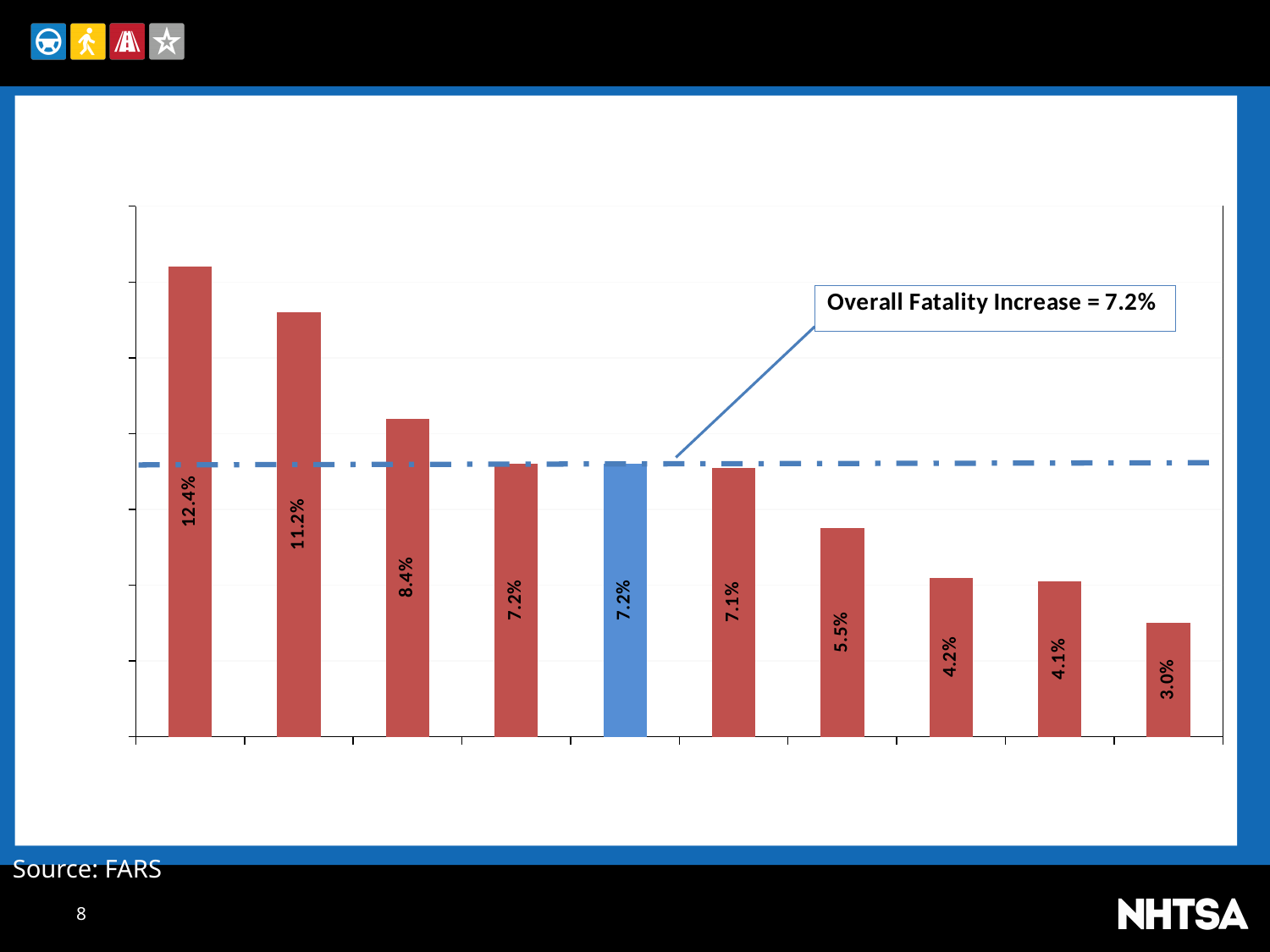
What is the value shown on the tallest bar in the chart? 12.4% What kind of chart is shown on the slide? bar chart What value is labelled on the blue bar in the chart? 7.2% What is the difference between the leftmost bar (12.4%) and the rightmost bar (3.0%)? 9.4% What value is labelled on the rightmost bar? 3.0% What value is labelled on the second bar from the left? 11.2% What is the source cited at the bottom of the slide? FARS How many bars are plotted in the chart? 10 What is the value shown on the shortest bar in the chart? 3.0% What does the text box annotation on the chart say? Overall Fatality Increase = 7.2% Which is larger, the third bar from the left or the bar immediately to the right of the blue bar? the third bar from the left (8.4%) Do the bar values rise or fall moving from left to right across the chart? fall